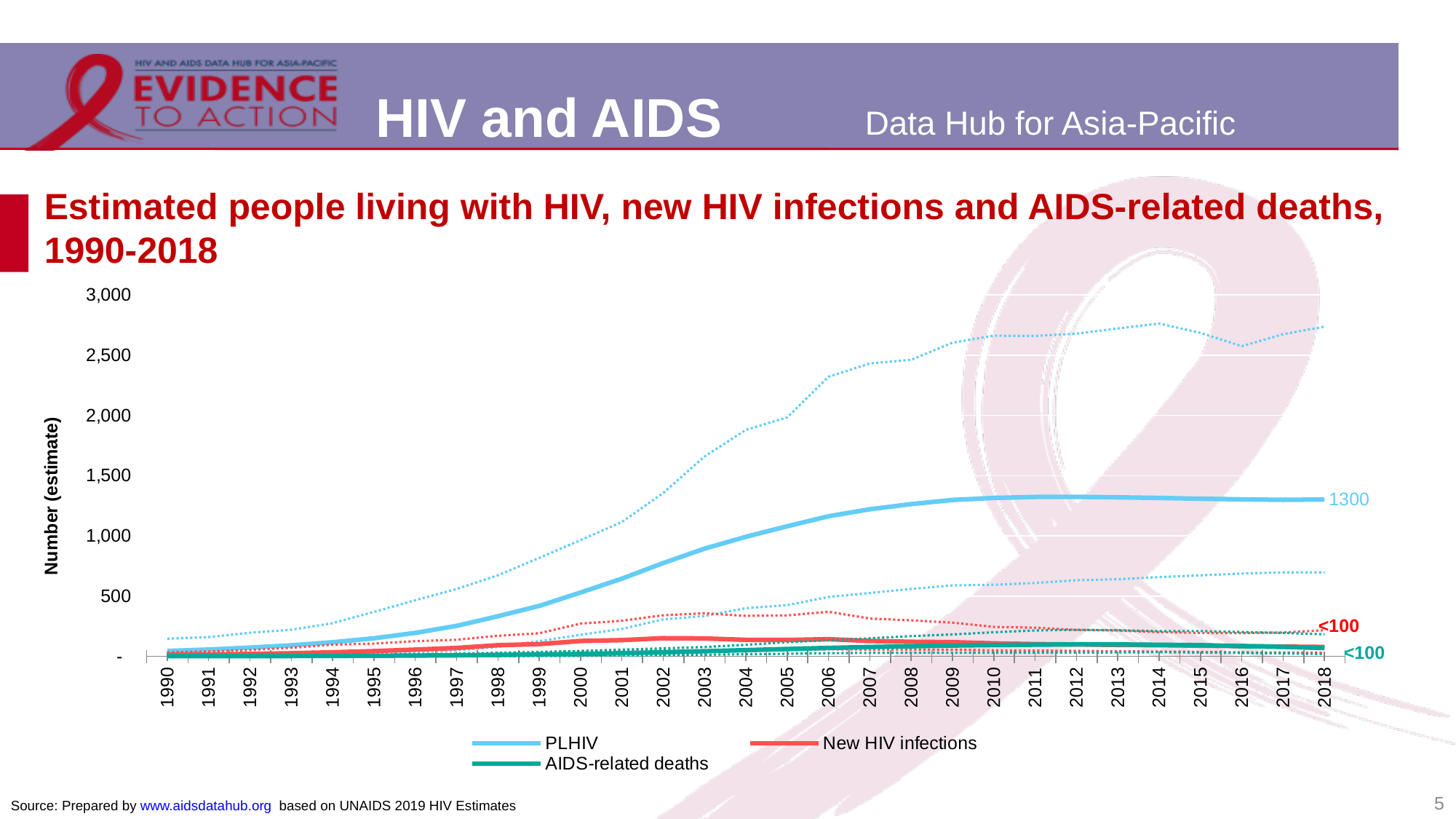
Which is larger in 2018, PLHIV or New HIV infections? PLHIV What is the labelled value for New HIV infections in 2018? <100 Which series has the highest value in 2018? PLHIV Does the PLHIV line rise or fall from 1990 to 2010? rise Is the value for PLHIV in 2012 greater or less than 1,000? greater What type of chart is shown on the slide? line chart What is the labelled value for AIDS-related deaths in 2018? <100 How many years are shown on the x axis? 29 How many series does the legend list? 3 Is the value for PLHIV in 1995 greater or less than 500? less What is the title of the y axis? Number (estimate) What is the labelled value for PLHIV in 2018? 1300